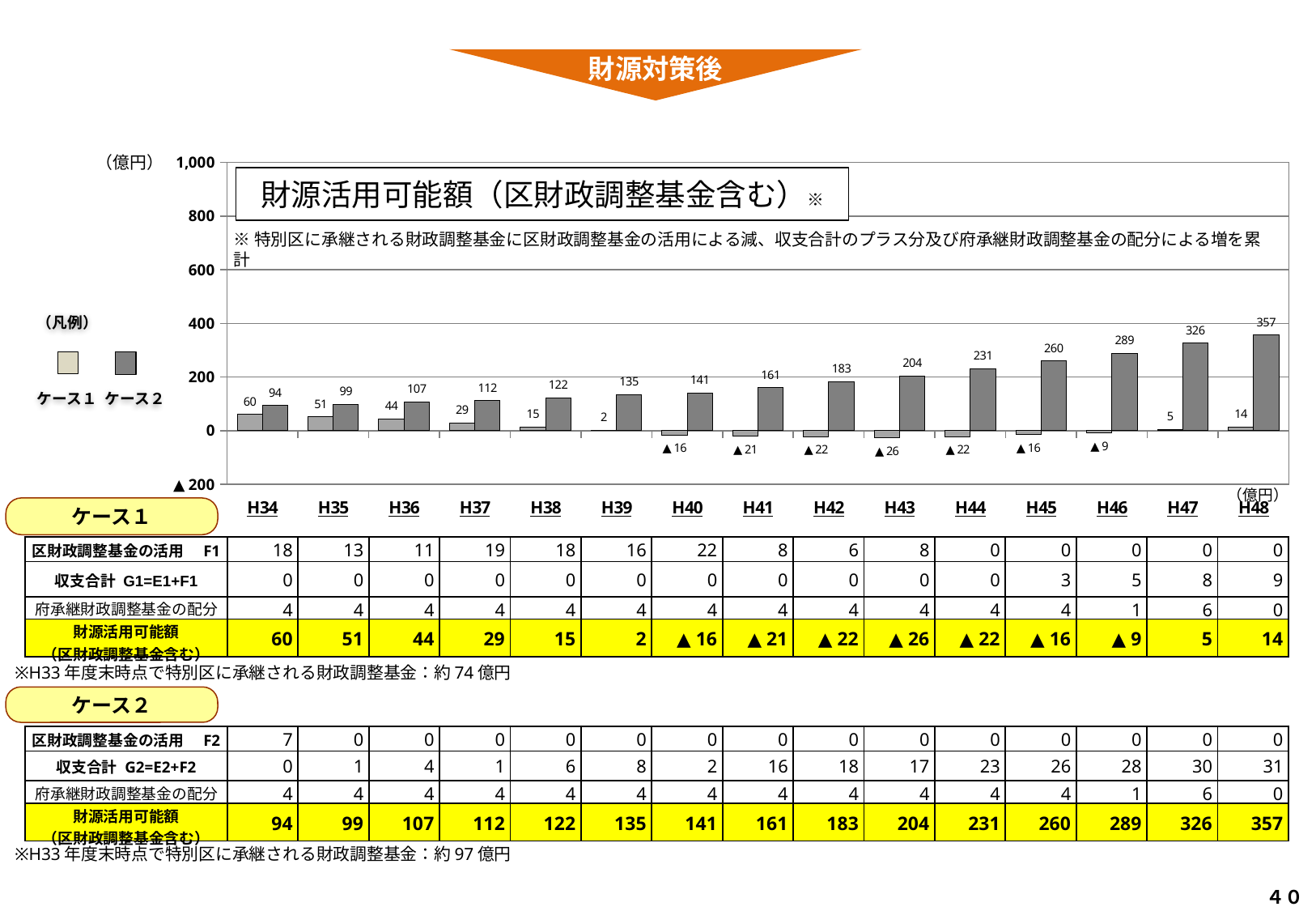
How many fiscal years (categories) are plotted along the x axis? 15 What is the value for ケース1 in H43? ▲ 26 Do the ケース2 values rise or fall from H34 to H48? rise What is the difference between the ケース2 and ケース1 values in H34? 34 In which year is the ケース2 value highest? H48 What kind of chart is shown on the slide? bar chart Which is larger in H40, the ケース1 value or the ケース2 value? ケース2 In which year is the ケース1 value lowest? H43 What is the title of the chart? 財源活用可能額（区財政調整基金含む） What is the value for ケース2 in H48? 357 How many series does the legend list? 2 What is the value for ケース1 in H37? 29